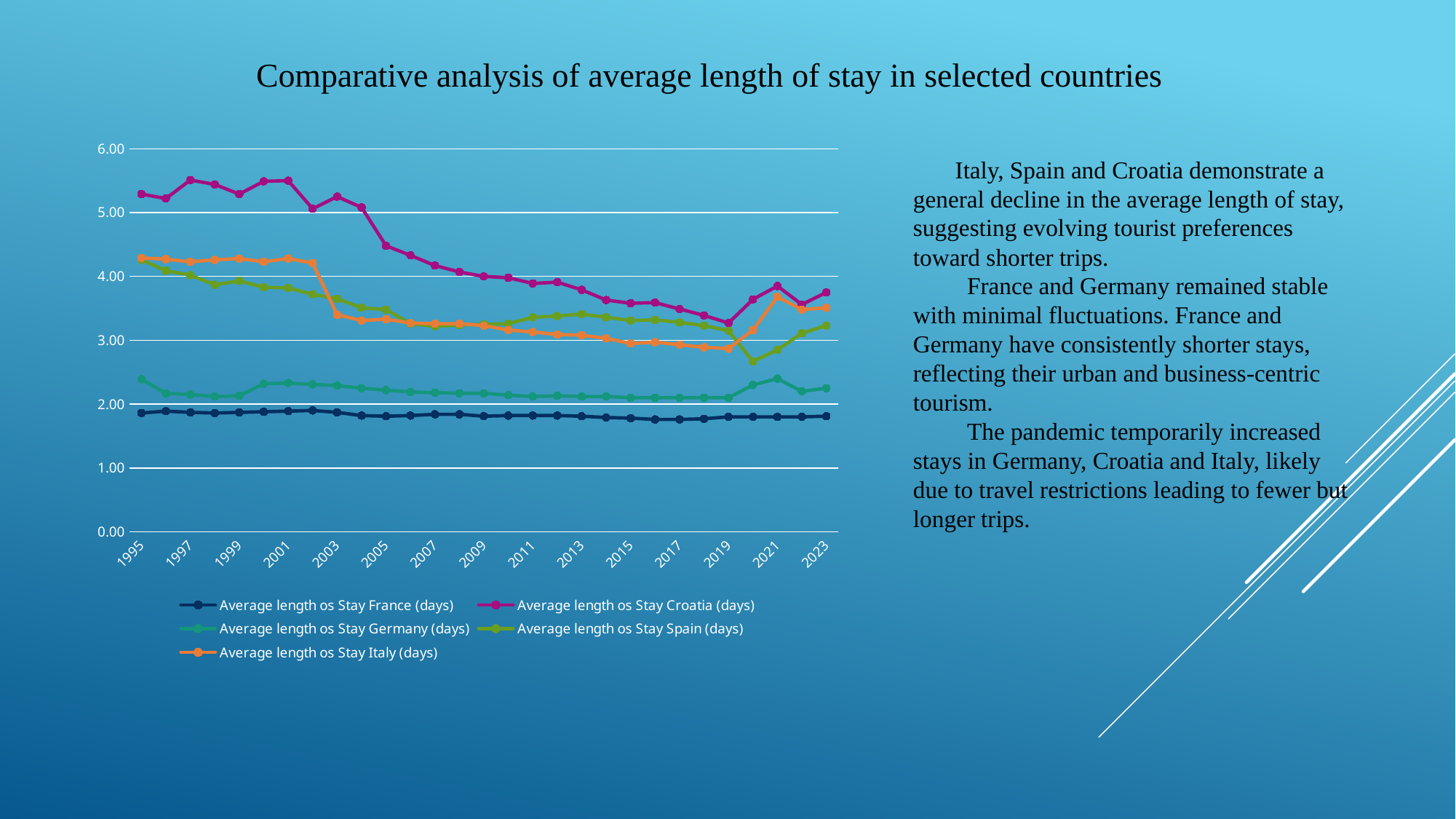
Is the value for France in 2023 greater or less than 2.00? less Which country has the highest average length of stay in 1995? Croatia How many years (data points per series) are plotted along the x axis, from 1995 to 2023? 29 Is the value for Italy in 2003 greater or less than 3.00? greater Which country has the lowest average length of stay in 2023? France In 2000, which is larger: the average length of stay in Italy or in Spain? Italy What kind of chart is shown on the slide? Line chart Is the value for Spain in 2020 greater or less than 3.00? less Does the average length of stay in Croatia rise or fall from 1995 to 2019? Fall How many series does the legend list? 5 What is the title of the chart on the slide? Comparative analysis of average length of stay in selected countries